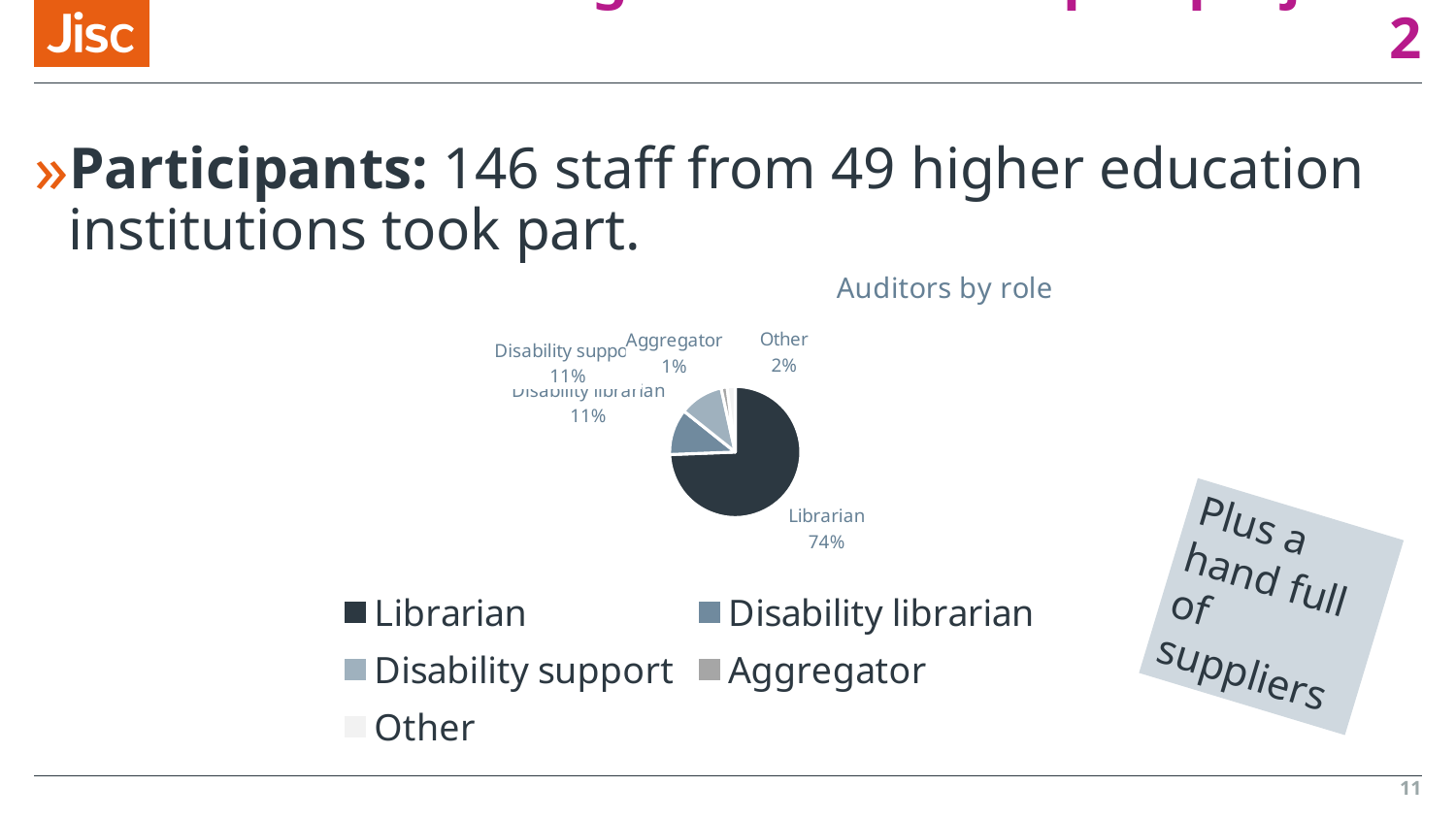
Which role has the smallest share of auditors? Aggregator What is the title of the chart? Auditors by role What share of auditors fall under Other? 2% What share of auditors are Disability librarians? 11% What kind of chart is shown on the slide? pie chart Which is larger, the share for Librarian or the share for Disability support? Librarian How many roles does the legend list? 5 What share of auditors are Aggregators? 1% What is the difference in percentage points between the Other share and the Aggregator share? 1 What share of auditors are Librarians? 74% What is the difference in percentage points between the Librarian share and the Disability librarian share? 63 Which role has the largest share of auditors? Librarian